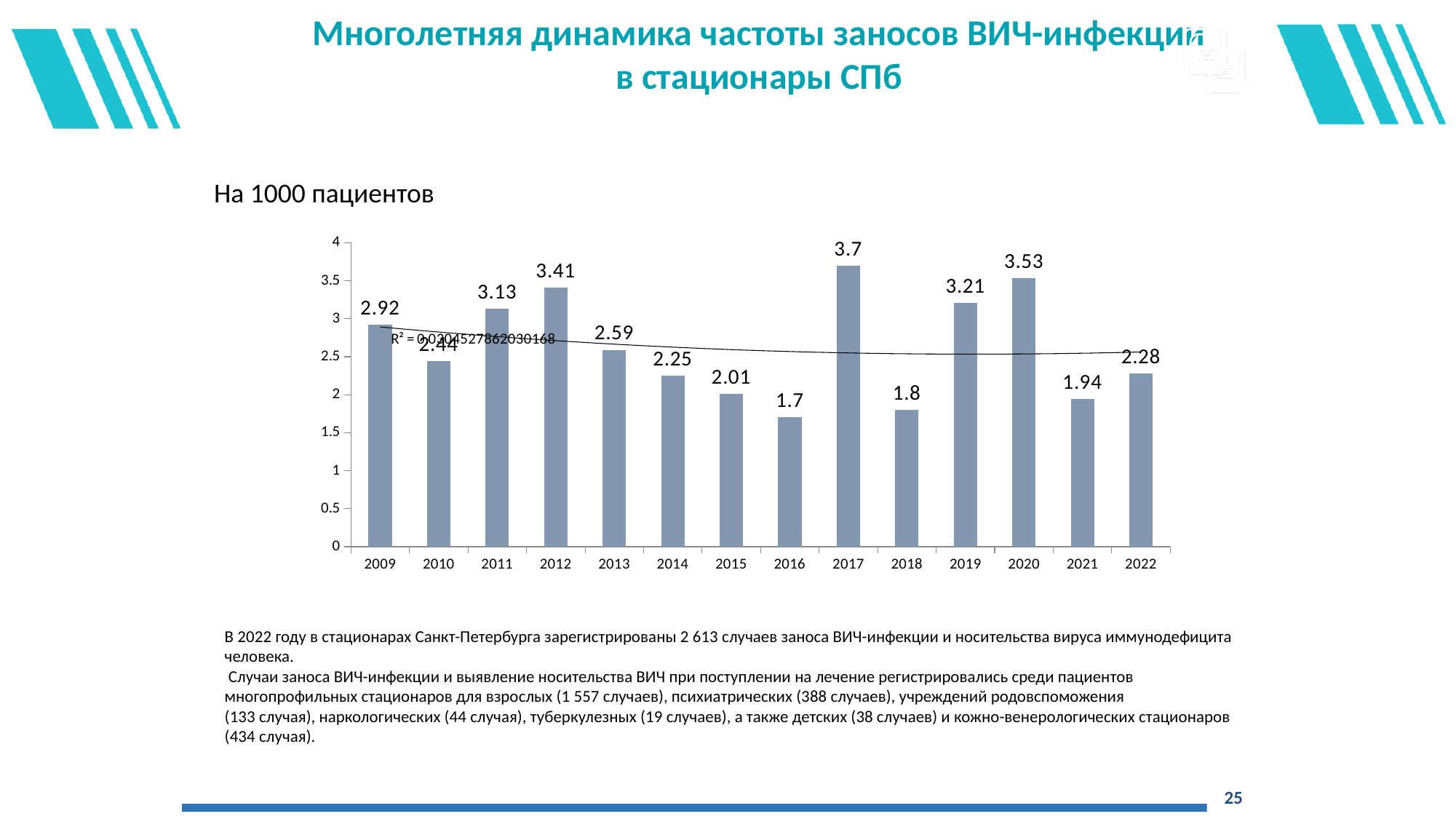
Is the value for 2018 greater or less than 2? less What is the difference between the values for 2020 and 2021? 1.59 Do the values rise or fall from 2012 to 2016? fall What is the value for 2017? 3.7 What is the value for 2012? 3.41 Which year has the lowest value? 2016 What kind of chart is shown on the slide? bar chart Which year has the highest value? 2017 How many years are shown on the x axis? 14 Which is larger, the value for 2011 or the value for 2019? 2019 What unit label is shown above the chart? На 1000 пациентов What is the value for 2022? 2.28